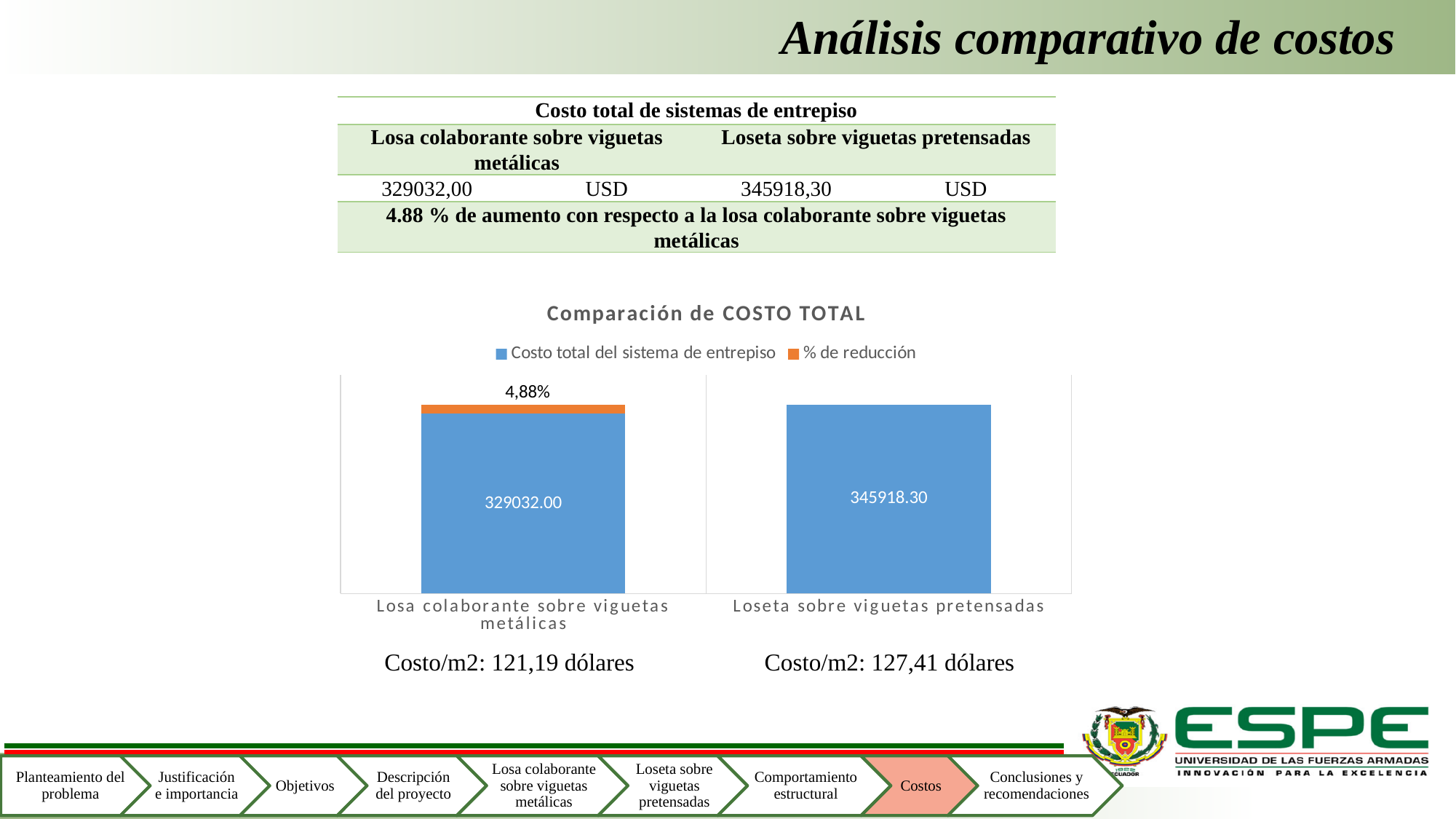
What percentage label is shown on the orange segment of the 'Losa colaborante sobre viguetas metálicas' bar? 4,88% Which category has the lower 'Costo total del sistema de entrepiso' value? Losa colaborante sobre viguetas metálicas Which series in the chart is shown in orange? % de reducción How many series does the chart legend list? 2 How many categories are shown on the x axis of the chart? 2 What is the value of 'Costo total del sistema de entrepiso' for 'Loseta sobre viguetas pretensadas'? 345918.30 What is the difference between the 'Costo total del sistema de entrepiso' values for 'Loseta sobre viguetas pretensadas' and 'Losa colaborante sobre viguetas metálicas'? 16886.30 Is the 'Costo total del sistema de entrepiso' value larger for 'Losa colaborante sobre viguetas metálicas' or for 'Loseta sobre viguetas pretensadas'? Loseta sobre viguetas pretensadas What is the title of the chart? Comparación de COSTO TOTAL Which category has the higher 'Costo total del sistema de entrepiso' value? Loseta sobre viguetas pretensadas What type of chart is shown on the slide? bar chart What is the value of 'Costo total del sistema de entrepiso' for 'Losa colaborante sobre viguetas metálicas'? 329032.00